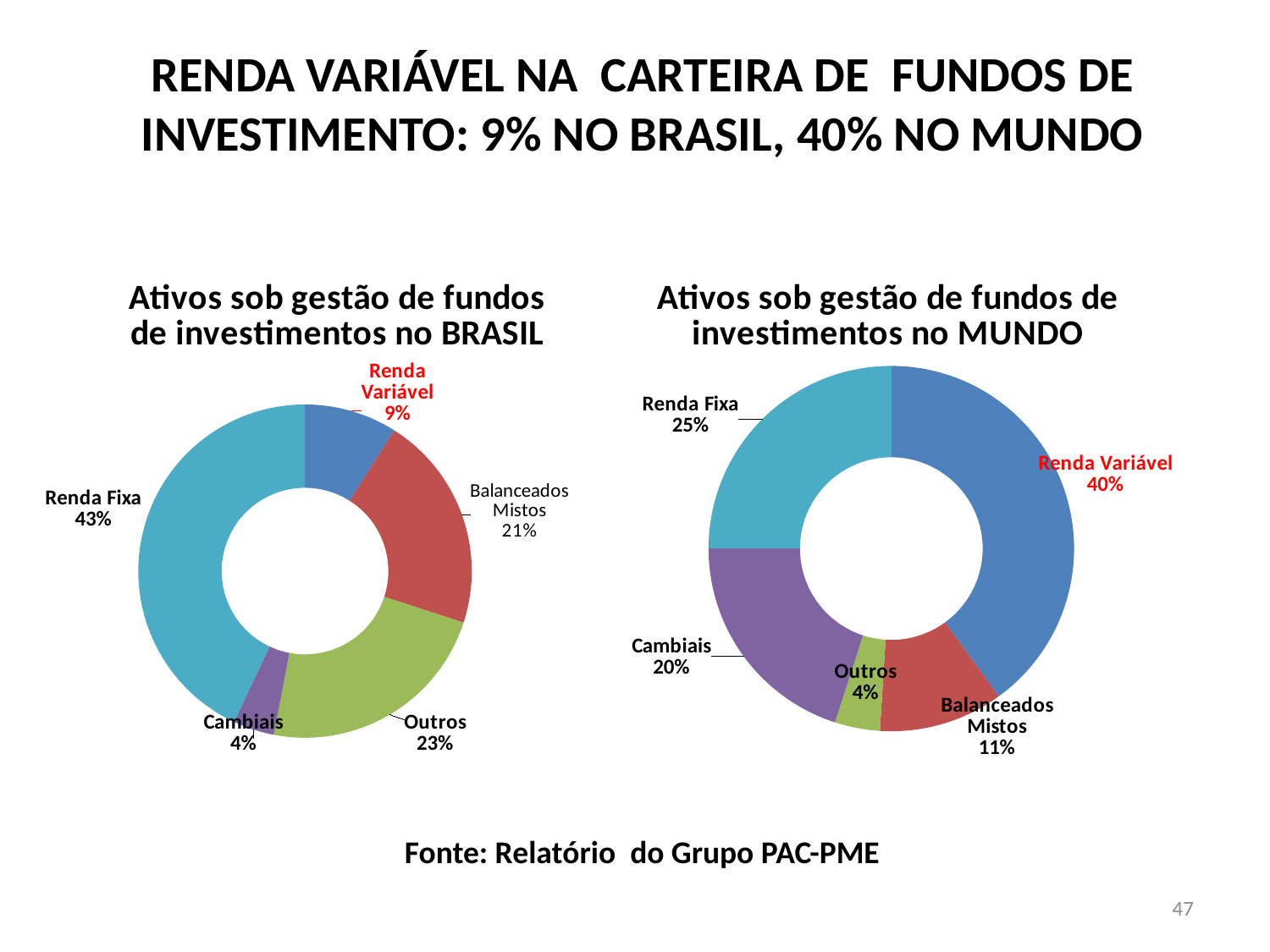
In the chart 'Ativos sob gestão de fundos de investimentos no MUNDO', which is larger: Renda Fixa or Cambiais? Renda Fixa In the chart 'Ativos sob gestão de fundos de investimentos no MUNDO', what is the share for Cambiais? 20% What is the source cited below the charts? Relatório do Grupo PAC-PME In the chart 'Ativos sob gestão de fundos de investimentos no BRASIL', what is the share for Renda Variável? 9% In the chart 'Ativos sob gestão de fundos de investimentos no MUNDO', what is the difference between the shares of Renda Variável and Balanceados Mistos? 29 percentage points What type of chart is 'Ativos sob gestão de fundos de investimentos no MUNDO'? Doughnut (pie) chart How many categories are shown in the chart 'Ativos sob gestão de fundos de investimentos no BRASIL'? 5 In the chart 'Ativos sob gestão de fundos de investimentos no BRASIL', what is the share for Balanceados Mistos? 21% In the chart 'Ativos sob gestão de fundos de investimentos no BRASIL', what is the difference between the shares of Renda Fixa and Outros? 20 percentage points In the chart 'Ativos sob gestão de fundos de investimentos no BRASIL', which category has the largest share? Renda Fixa In the chart 'Ativos sob gestão de fundos de investimentos no MUNDO', which category has the smallest share? Outros In the chart 'Ativos sob gestão de fundos de investimentos no MUNDO', what is the share for Renda Variável? 40%